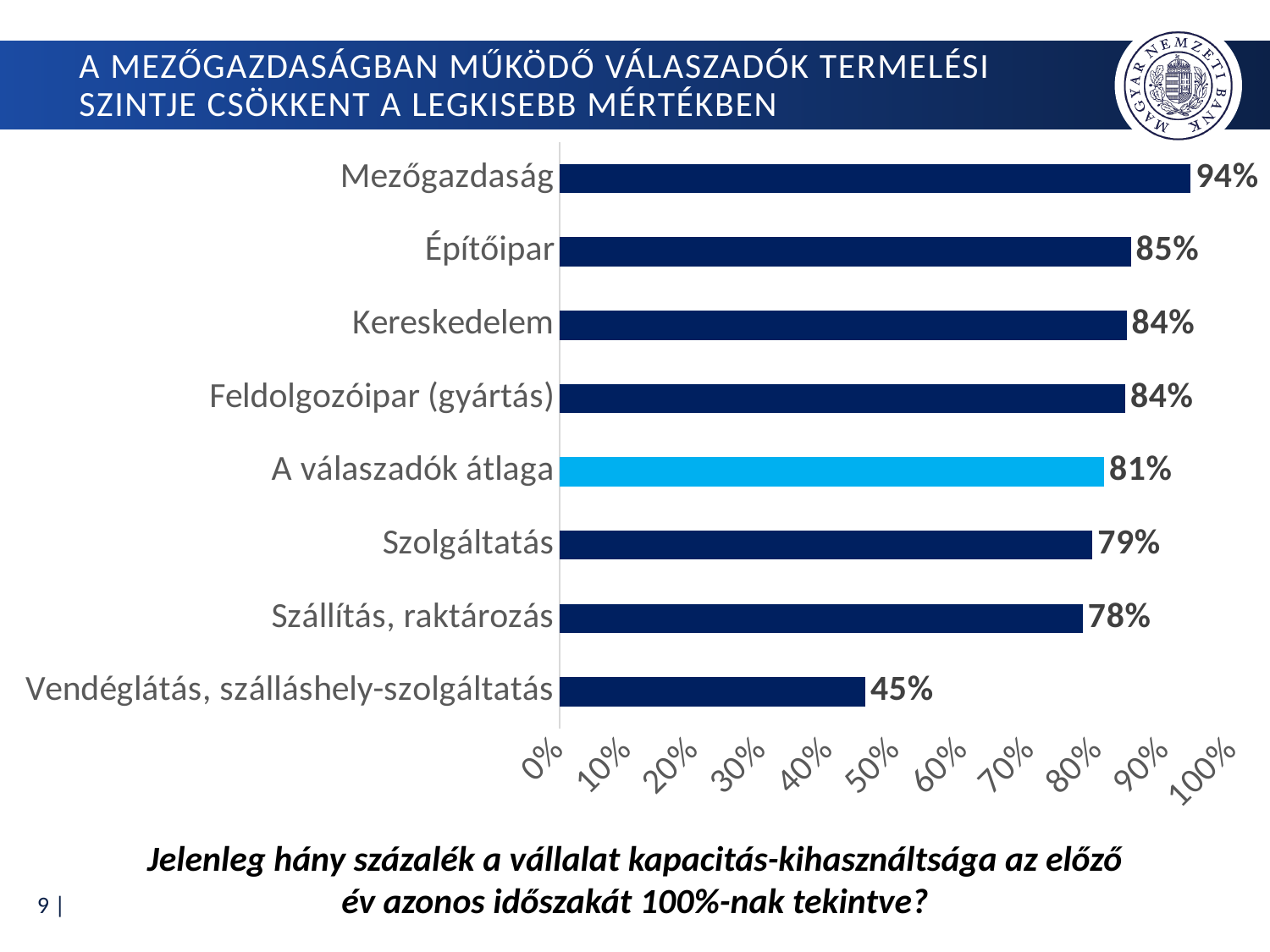
Which category has the highest value? Mezőgazdaság What is the value for Mezőgazdaság? 94% Which bar is shown in a lighter blue colour than the others? A válaszadók átlaga What is the value for Szállítás, raktározás? 78% Which is larger, the value for Építőipar or the value for Szolgáltatás? Építőipar What is the value for A válaszadók átlaga? 81% What is the difference between the values for Építőipar and Szolgáltatás? 6% How many categories are shown in the chart? 8 What is the value for Vendéglátás, szálláshely-szolgáltatás? 45% What is the difference between the values for Mezőgazdaság and Vendéglátás, szálláshely-szolgáltatás? 49% What kind of chart is shown on the slide? Bar chart Which category has the lowest value? Vendéglátás, szálláshely-szolgáltatás